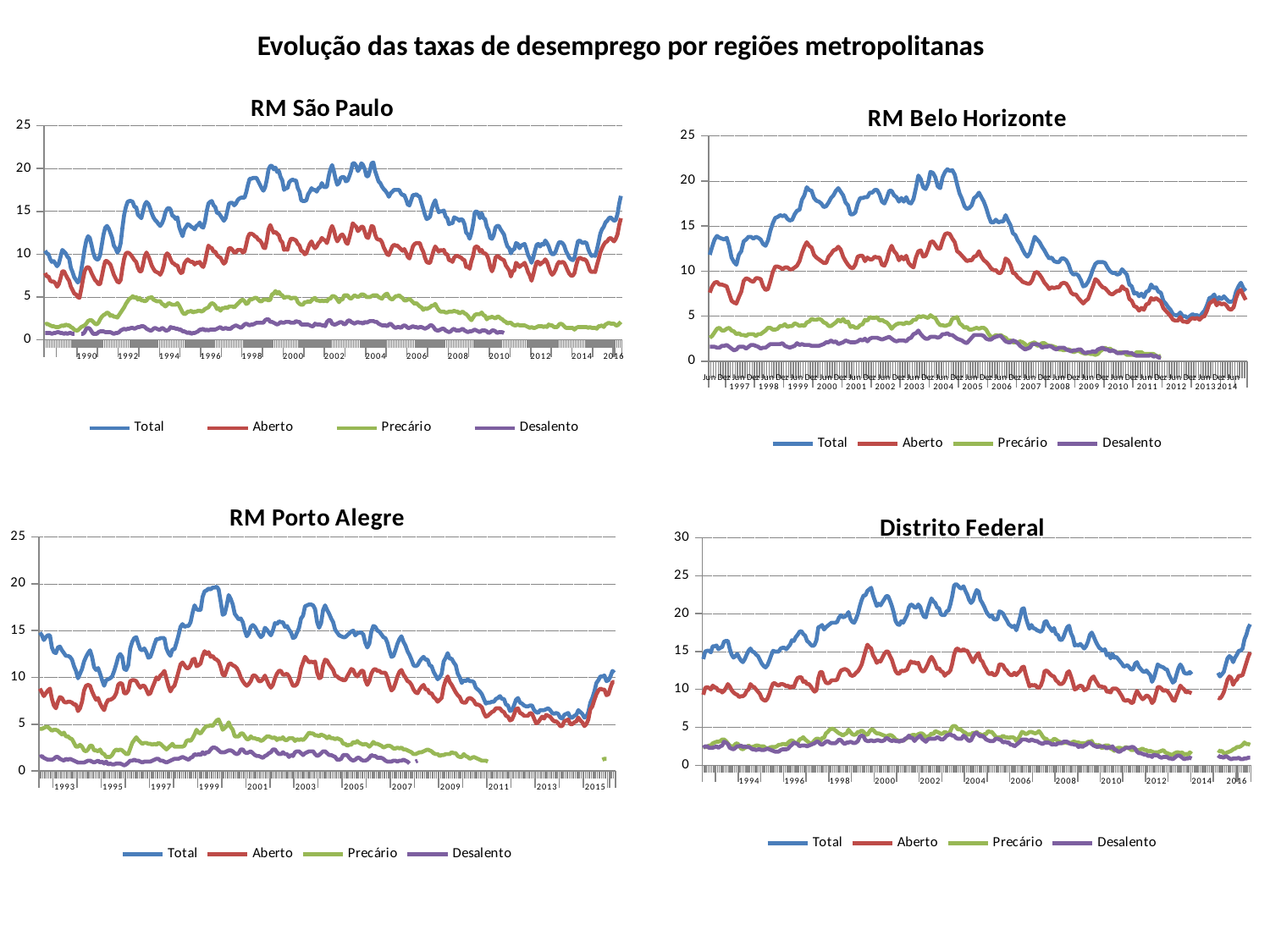
How many charts are shown on the slide? 4 What kind of chart is the RM São Paulo chart? line chart In the RM São Paulo chart, is the peak value of the Total series greater or less than 15? greater In the RM Porto Alegre chart, which series is higher, Aberto or Precário? Aberto In the RM Belo Horizonte chart, does the Total series rise or fall between 2004 and 2012? fall What is the title of the slide? Evolução das taxas de desemprego por regiões metropolitanas How many series does the legend of the RM Belo Horizonte chart list? 4 In the RM São Paulo chart, which series has the lowest values? Desalento In the RM Porto Alegre chart, is the Total series around 2013 greater or less than 10? less What is the maximum value shown on the y axis of the Distrito Federal chart? 30 In the RM Belo Horizonte chart, which series is higher, Total or Precário? Total In the Distrito Federal chart, is the Desalento series greater or less than 5 throughout the period? less